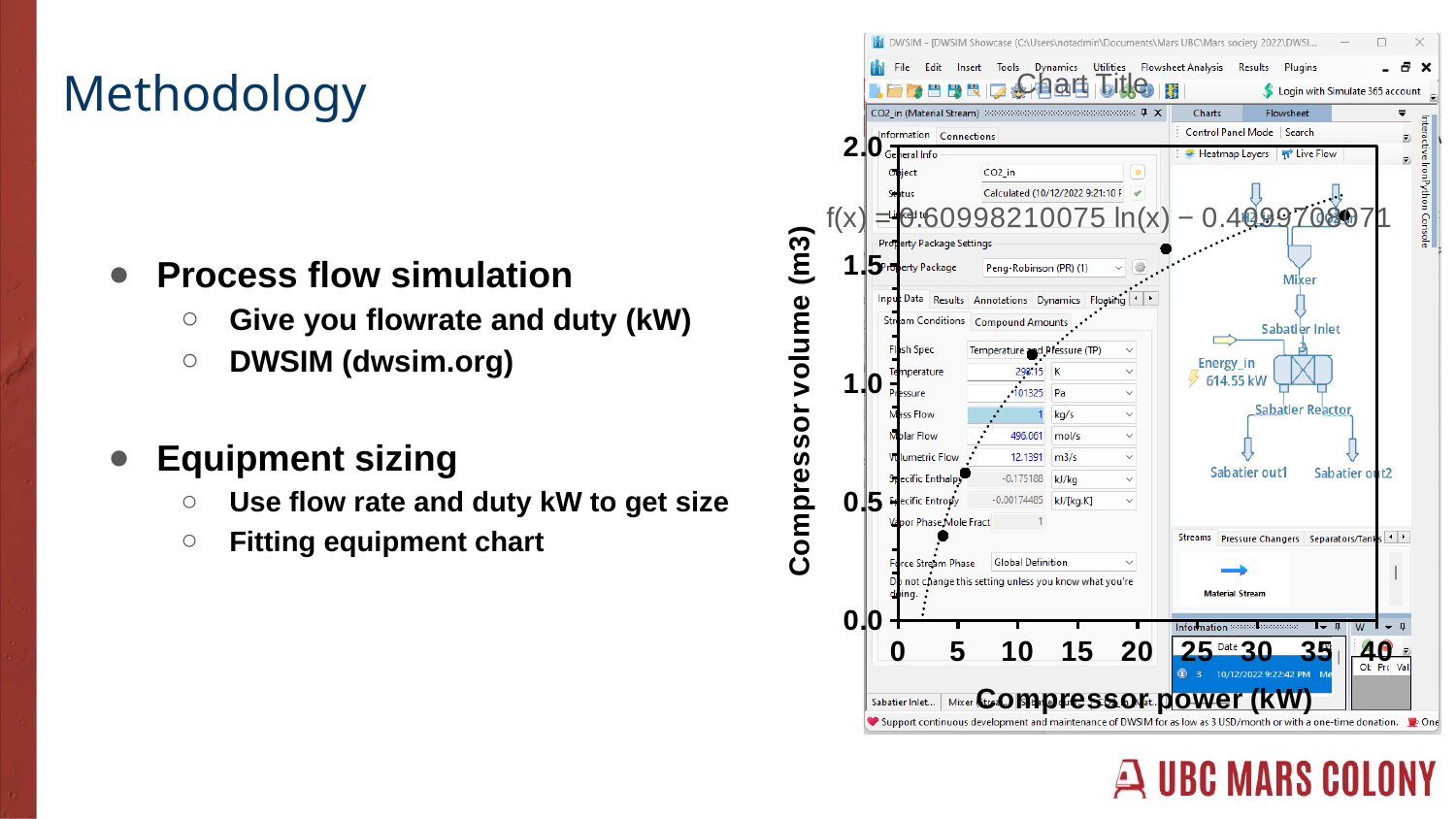
Is the compressor volume for the rightmost data point (near 35 kW) greater or less than 1.5? greater Is the compressor volume for the leftmost data point (near 4 kW) greater or less than 1.0? less What is the highest value shown on the x axis of the chart? 40 Is the compressor volume for the data point near 22 kW greater or less than 1.0? greater What is the title of the chart on the slide? Chart Title What is the label of the y axis of the chart? Compressor volume (m3) Does compressor volume rise or fall as compressor power increases along the x axis? Rise What kind of chart is shown on the slide? Scatter chart with a trendline